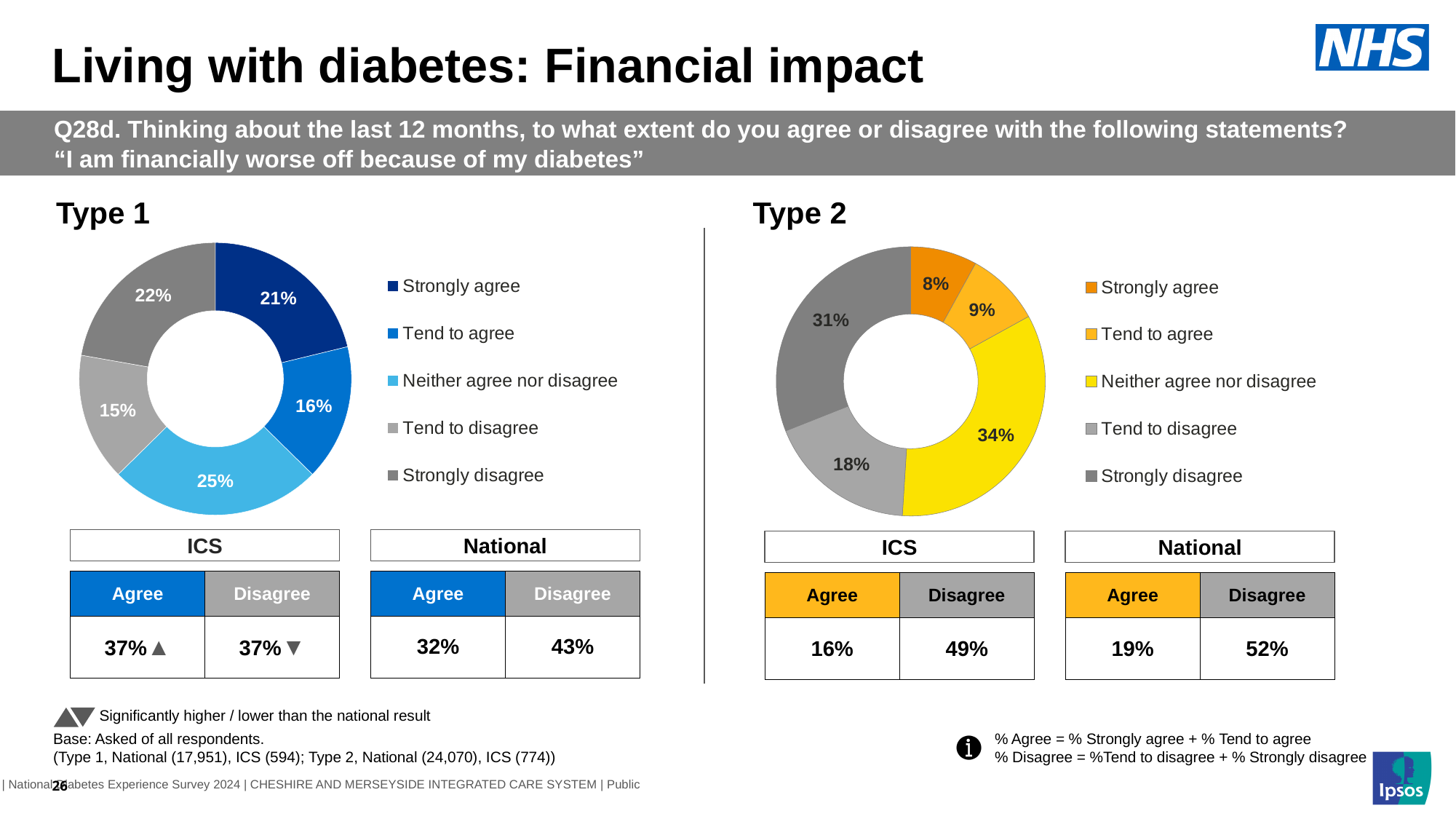
In the Type 1 chart, which response category has the largest share? Neither agree nor disagree In the Type 2 chart, what colour represents Neither agree nor disagree? Yellow In the Type 2 chart, what is the difference in percentage points between Neither agree nor disagree and Tend to disagree? 16 In the Type 2 chart, what percentage of respondents said they tend to agree? 9% In the Type 1 chart, what percentage of respondents said they strongly agree? 21% What type of chart is used for the Type 2 data? Pie (donut) chart In the Type 2 chart, which response category has the smallest share? Strongly agree In the Type 1 chart, what is the difference in percentage points between Strongly disagree and Tend to disagree? 7 How many response categories are shown in the Type 1 chart? 5 In the Type 1 chart, what percentage of respondents said they neither agree nor disagree? 25% In the Type 2 chart, which is larger: the share for Strongly disagree or the share for Tend to disagree? Strongly disagree In the Type 2 chart, what percentage of respondents said they strongly disagree? 31%